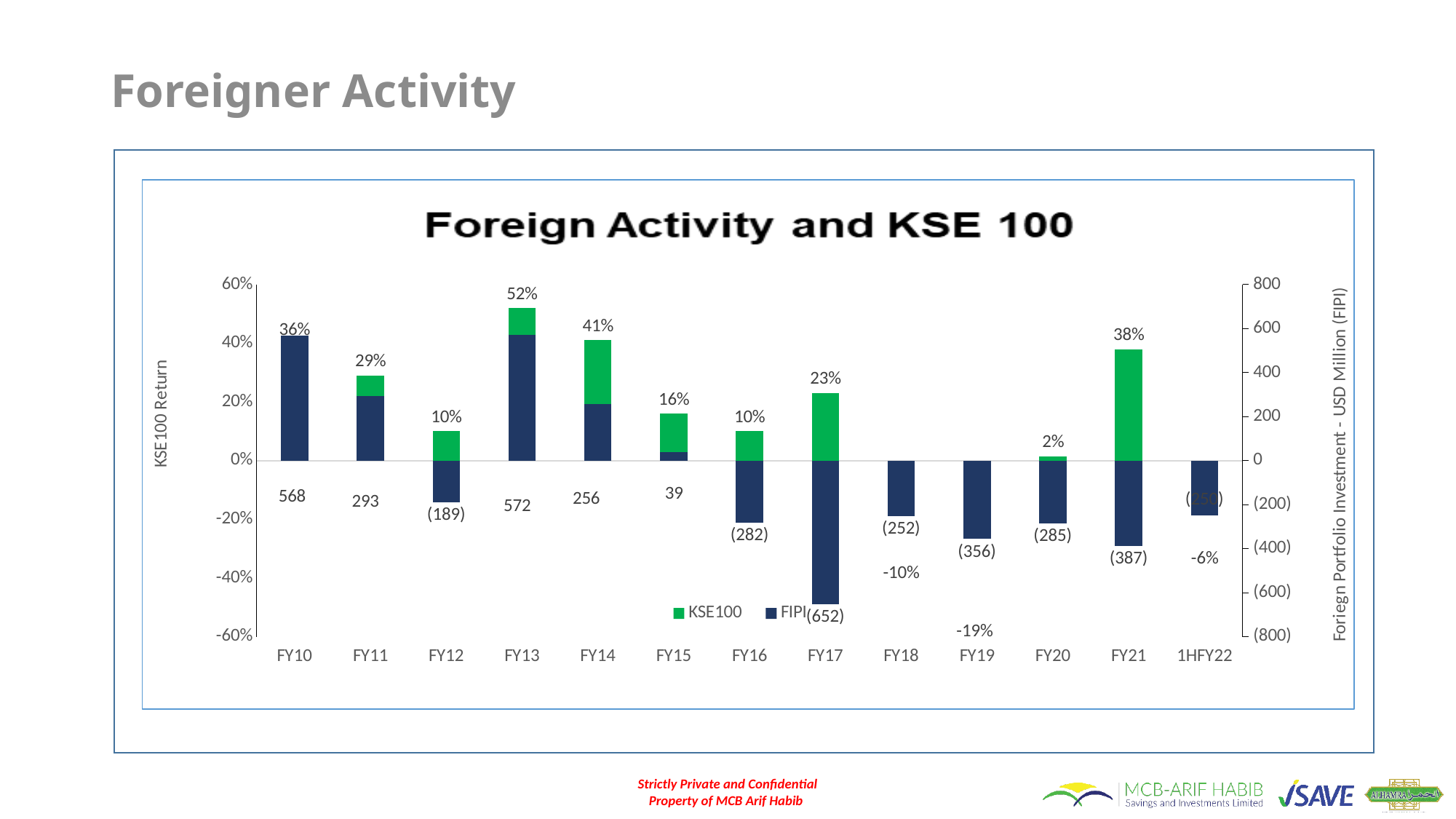
What is the KSE100 return for FY19? -19% What type of chart is shown? Bar chart What is the FIPI value for FY17? (652) How many fiscal periods are shown on the x axis? 13 What is the difference between the FIPI values for FY13 and FY10? 4 Which fiscal year has the highest KSE100 return? FY13 Which is larger, the KSE100 return for FY14 or for FY21? FY14 Which fiscal year has the lowest FIPI value? FY17 What is the KSE100 return for FY13? 52% What is the FIPI value for FY10? 568 Which fiscal year has the highest FIPI value? FY13 How many series does the legend list? 2